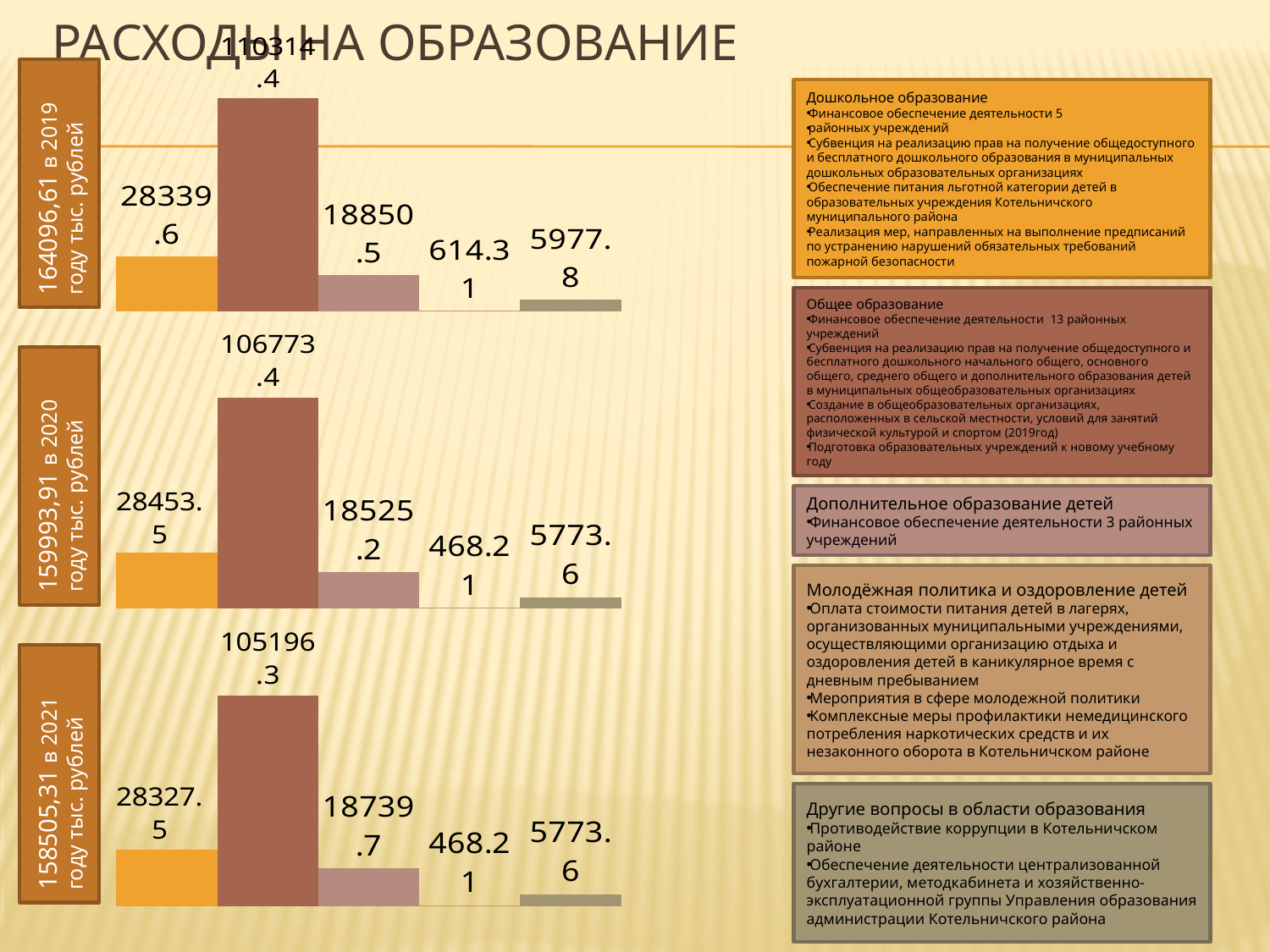
On the 2020 chart (labelled 159993,91 в 2020 году тыс. рублей), what is the value of the first (orange) bar? 28453.5 On the 2019 chart, what is the value of the fourth bar? 614.31 On the 2019 chart, which is larger: the first bar (28339.6) or the third bar (18850.5)? the first bar (28339.6) On the 2021 chart, what is the difference between the last bar (5773.6) and the fourth bar (468.21)? 5305.39 On the 2021 chart (labelled 158505,31 в 2021 году тыс. рублей), what is the value of the smallest bar? 468.21 How many separate bar charts are shown on the slide? 3 On the 2019 chart (labelled 164096,61 в 2019 году тыс. рублей), what is the value of the tallest bar? 110314.4 On the 2020 chart, what is the value of the last (olive) bar? 5773.6 How many bars are plotted on the 2019 chart? 5 On the 2021 chart, what is the value of the third (pink) bar? 18739.7 On the 2020 chart, what is the difference between the second bar (106773.4) and the first bar (28453.5)? 78319.9 What type of chart is used for the 2021 data? bar chart